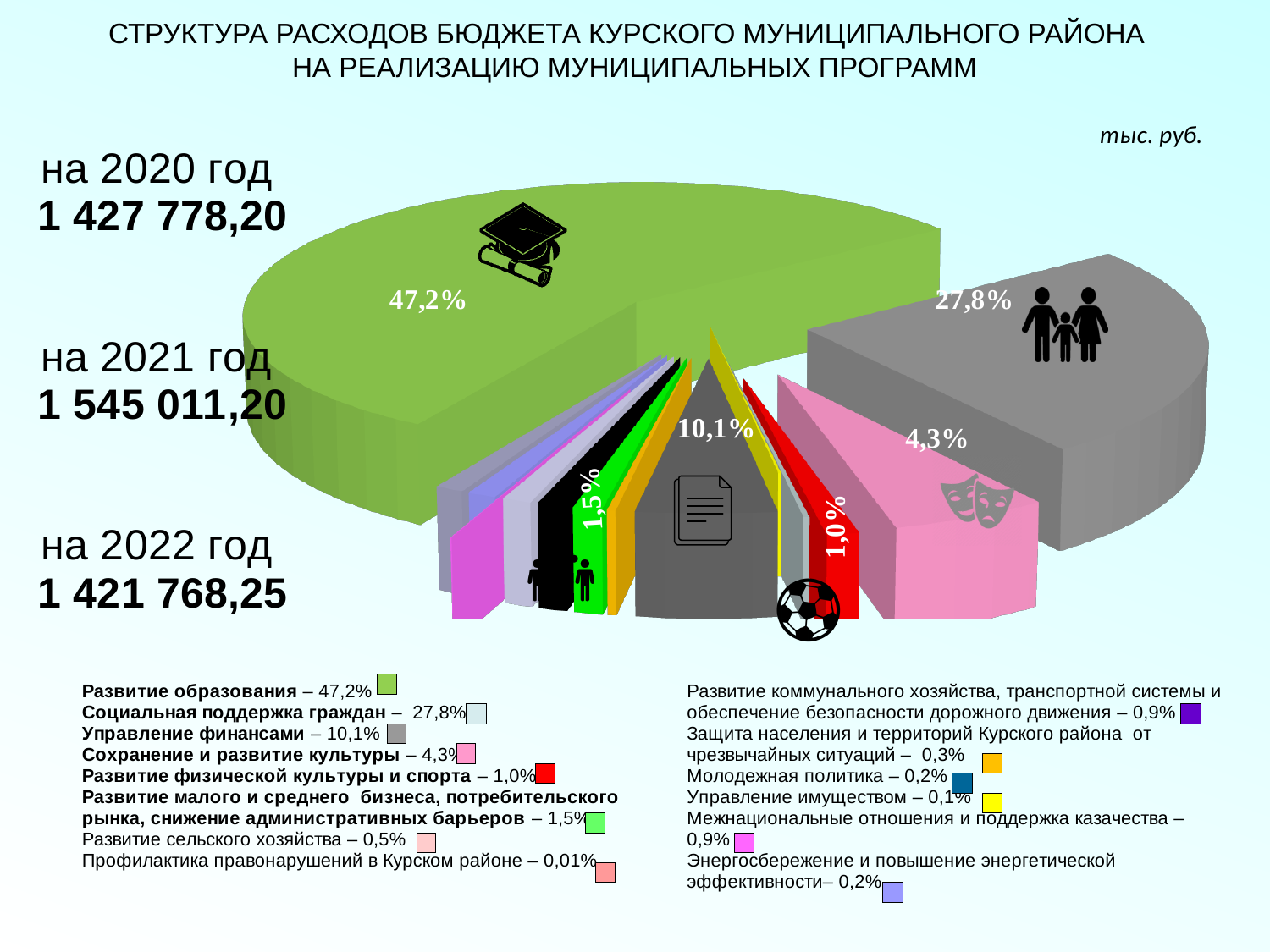
What share of the pie does "Социальная поддержка граждан" have? 27,8% Which category has the smallest share according to the legend? Профилактика правонарушений в Курском районе What kind of chart is shown on the slide? pie chart What is the value for "Управление финансами"? 10,1% What is the value for "Развитие физической культуры и спорта"? 1,0% What is the budget expenditure figure shown for 2021 (на 2021 год)? 1 545 011,20 What is the value for "Сохранение и развитие культуры"? 4,3% Which category has the largest slice of the pie? Развитие образования What share of the pie does "Развитие образования" have? 47,2% Which is larger: the share for "Управление финансами" or for "Сохранение и развитие культуры"? Управление финансами How many categories does the legend list? 14 What is the difference between the shares of "Развитие образования" and "Социальная поддержка граждан"? 19,4%